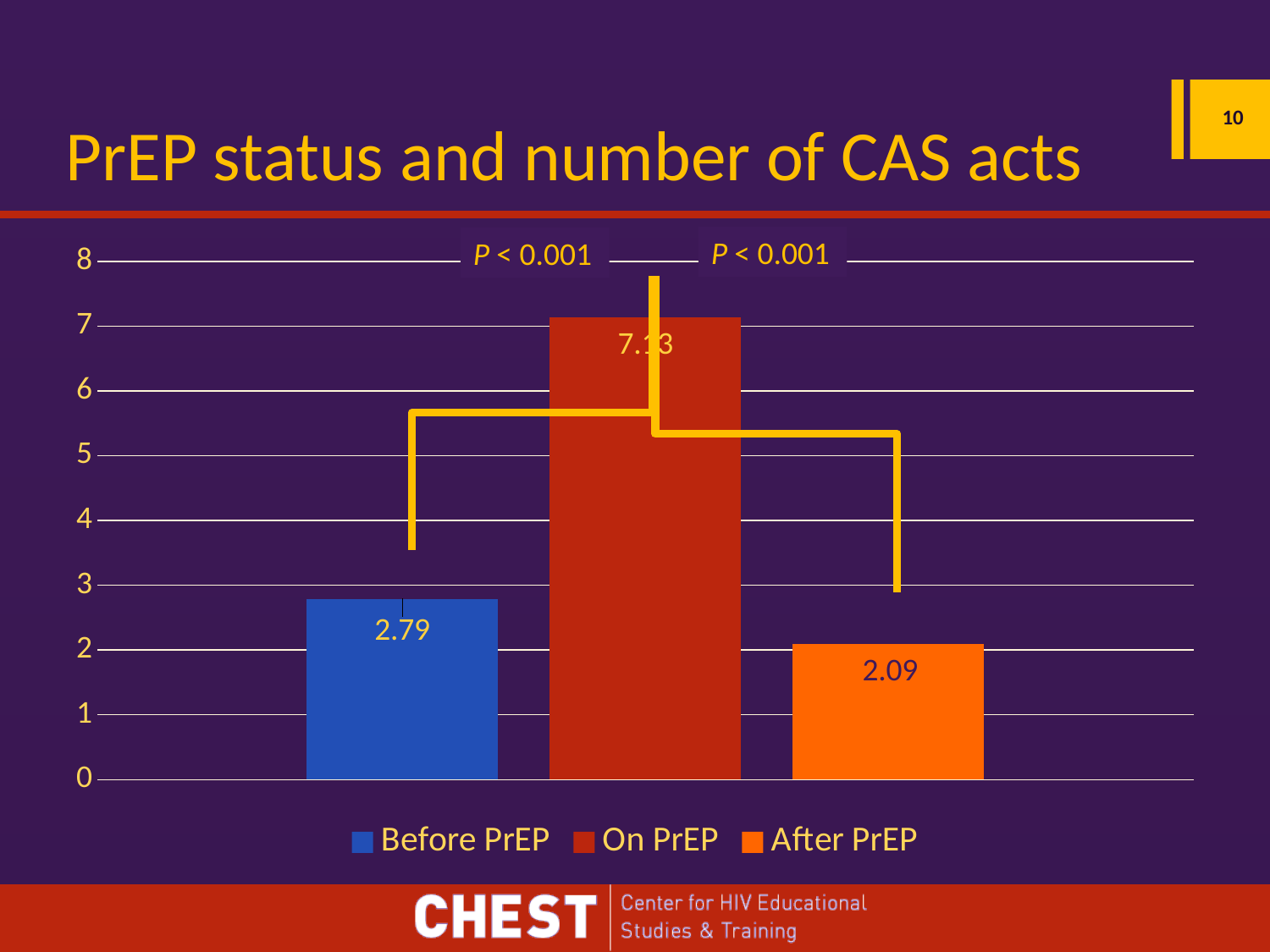
What is the value for After PrEP? 2.09 What kind of chart is shown on the slide? bar chart Which PrEP status has the lowest number of CAS acts? After PrEP Is the value for Before PrEP greater or less than 3? less What is the difference between the Before PrEP and After PrEP values? 0.70 Which PrEP status has the highest number of CAS acts? On PrEP What is the value for Before PrEP? 2.79 How many bars are plotted in the chart? 3 What is the title of the chart? PrEP status and number of CAS acts Which is larger, the value for Before PrEP or the value for After PrEP? Before PrEP Is the value for On PrEP greater or less than 6? greater How many series does the legend list? 3